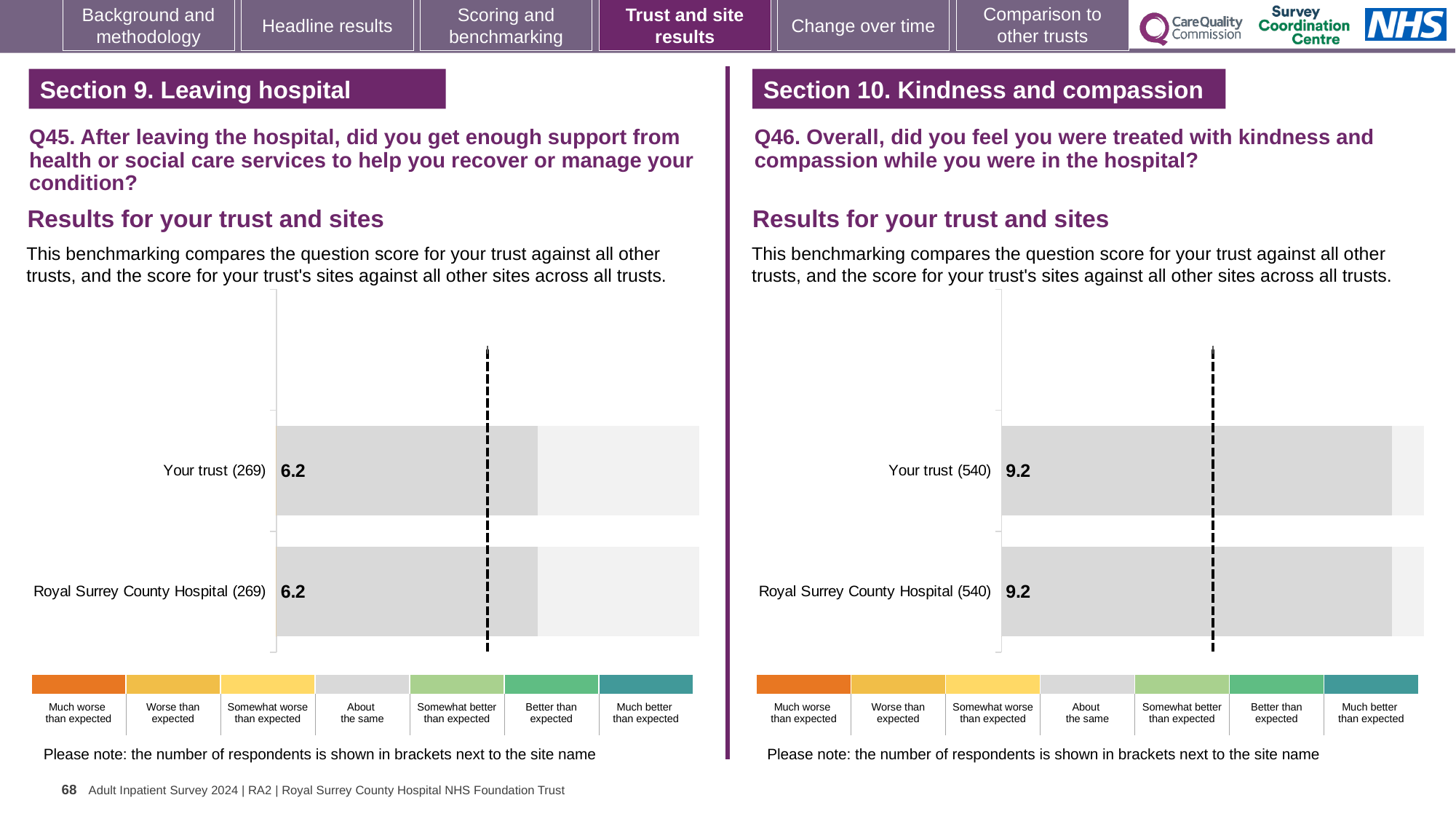
On the left chart (Q45, Leaving hospital), what is the score for Your trust? 6.2 On the left chart (Q45), how many bars are plotted? 2 On the left chart (Q45), how many respondents are shown in brackets next to Your trust? 269 On the right chart (Q46, Kindness and compassion), what is the score for Your trust? 9.2 On the right chart (Q46), how many bars are plotted? 2 What kind of chart is used on the left (Q45) to show the results for your trust and sites? Bar chart On the left chart (Q45), what is the difference between the score for Your trust and the score for Royal Surrey County Hospital? 0 On the left chart (Q45, Leaving hospital), what is the score for Royal Surrey County Hospital? 6.2 On the right chart (Q46), how many respondents are shown in brackets next to Royal Surrey County Hospital? 540 On the right chart (Q46, Kindness and compassion), what is the score for Royal Surrey County Hospital? 9.2 On the right chart (Q46), what is the difference between the score for Your trust and the score for Royal Surrey County Hospital? 0 Is the score for Your trust on the right chart (Q46) larger or smaller than the score for Your trust on the left chart (Q45)? Larger